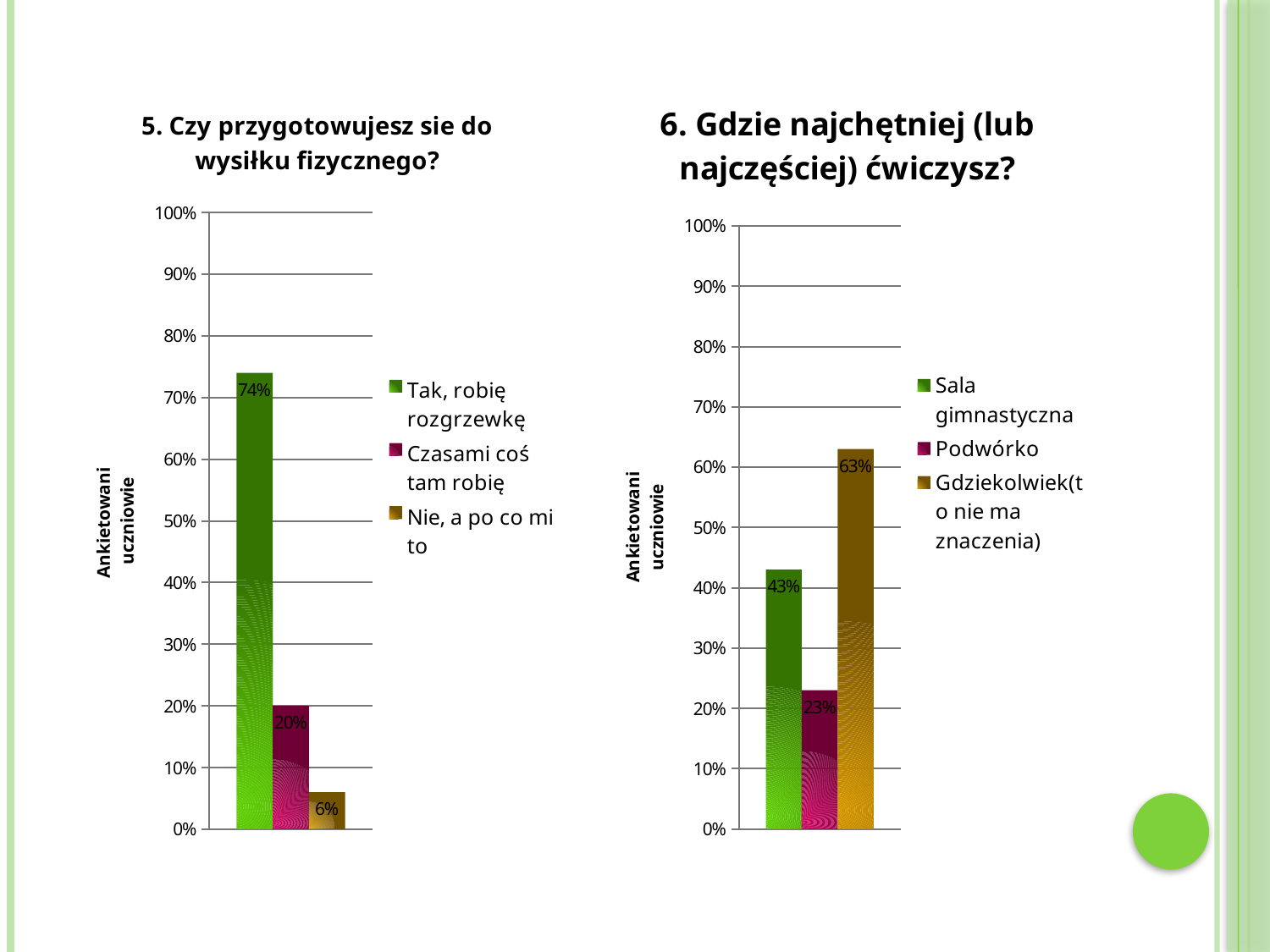
What kind of chart is the chart titled "6. Gdzie najchętniej (lub najczęściej) ćwiczysz?"? Bar chart In the chart titled "6. Gdzie najchętniej (lub najczęściej) ćwiczysz?", what is the value for "Gdziekolwiek(to nie ma znaczenia)"? 63% In the chart titled "6. Gdzie najchętniej (lub najczęściej) ćwiczysz?", which is larger: "Sala gimnastyczna" or "Podwórko"? Sala gimnastyczna In the chart titled "6. Gdzie najchętniej (lub najczęściej) ćwiczysz?", what is the difference between "Gdziekolwiek(to nie ma znaczenia)" and "Sala gimnastyczna"? 20% In the chart titled "5. Czy przygotowujesz sie do wysiłku fizycznego?", what is the value for "Tak, robię rozgrzewkę"? 74% What is the y-axis label of the chart titled "5. Czy przygotowujesz sie do wysiłku fizycznego?"? Ankietowani uczniowie In the chart titled "6. Gdzie najchętniej (lub najczęściej) ćwiczysz?", which series has the highest value? Gdziekolwiek(to nie ma znaczenia) In the chart titled "5. Czy przygotowujesz sie do wysiłku fizycznego?", what is the difference between "Tak, robię rozgrzewkę" and "Czasami coś tam robię"? 54% In the chart titled "5. Czy przygotowujesz sie do wysiłku fizycznego?", what is the value for "Nie, a po co mi to"? 6% In the chart titled "5. Czy przygotowujesz sie do wysiłku fizycznego?", how many series does the legend list? 3 In the chart titled "6. Gdzie najchętniej (lub najczęściej) ćwiczysz?", what is the value for "Podwórko"? 23% In the chart titled "5. Czy przygotowujesz sie do wysiłku fizycznego?", which series has the lowest value? Nie, a po co mi to